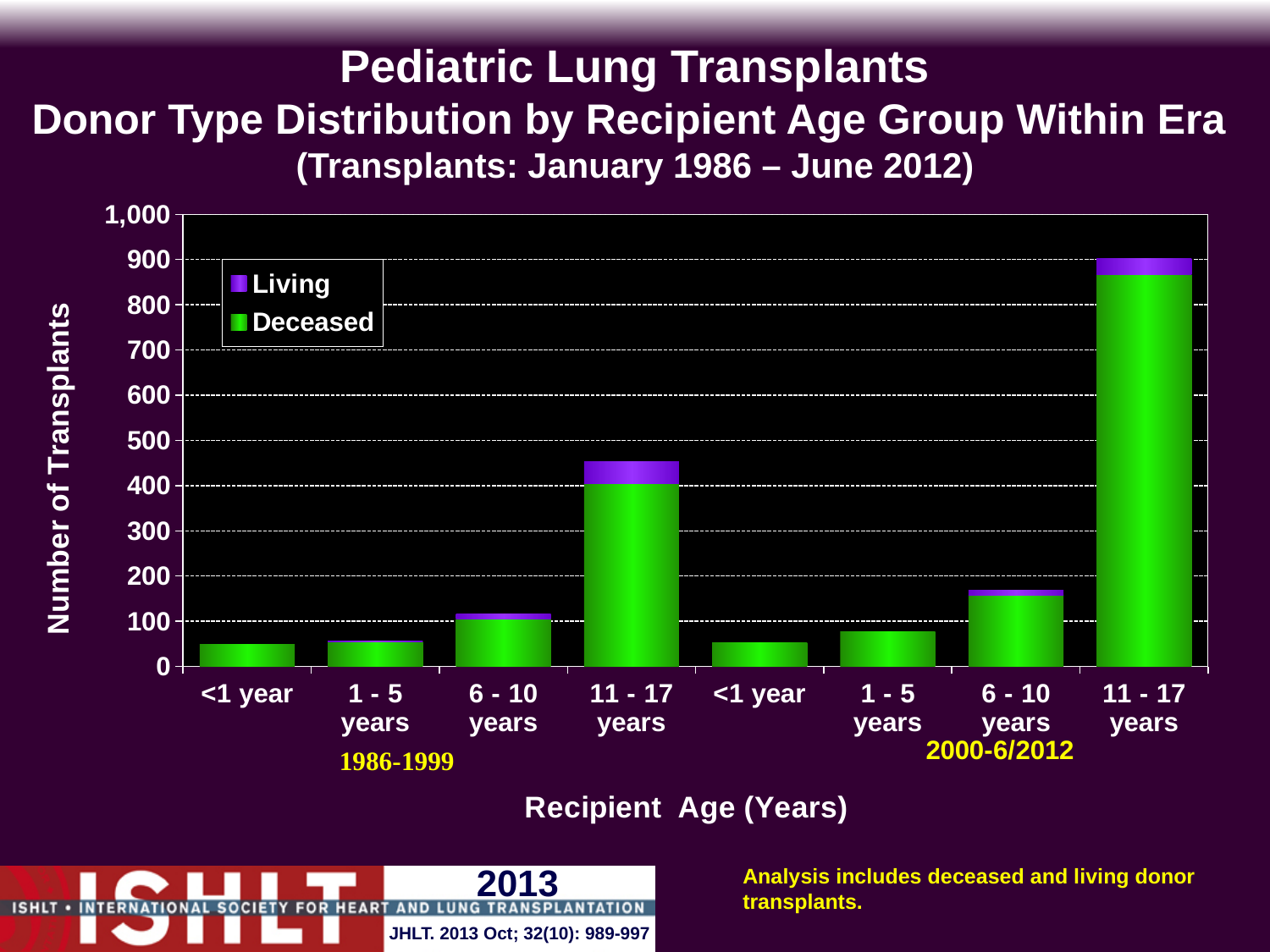
Which is larger: the total for 11 - 17 years in 1986-1999 or in 2000-6/2012? 2000-6/2012 Which is larger: the total for 6 - 10 years in 1986-1999 or in 2000-6/2012? 2000-6/2012 Is the total for 11 - 17 years in the 1986-1999 era greater or less than 400? greater How many series does the legend list? 2 Is the total for 11 - 17 years in the 2000-6/2012 era greater or less than 1,000? less What kind of chart is shown on the slide? bar chart Is the total for 6 - 10 years in the 1986-1999 era greater or less than 200? less Which bar has the highest total number of transplants? 11 - 17 years (2000-6/2012) How many bars are plotted in the chart? 8 Which colour represents the Living series in the legend? purple What is the label of the y axis? Number of Transplants